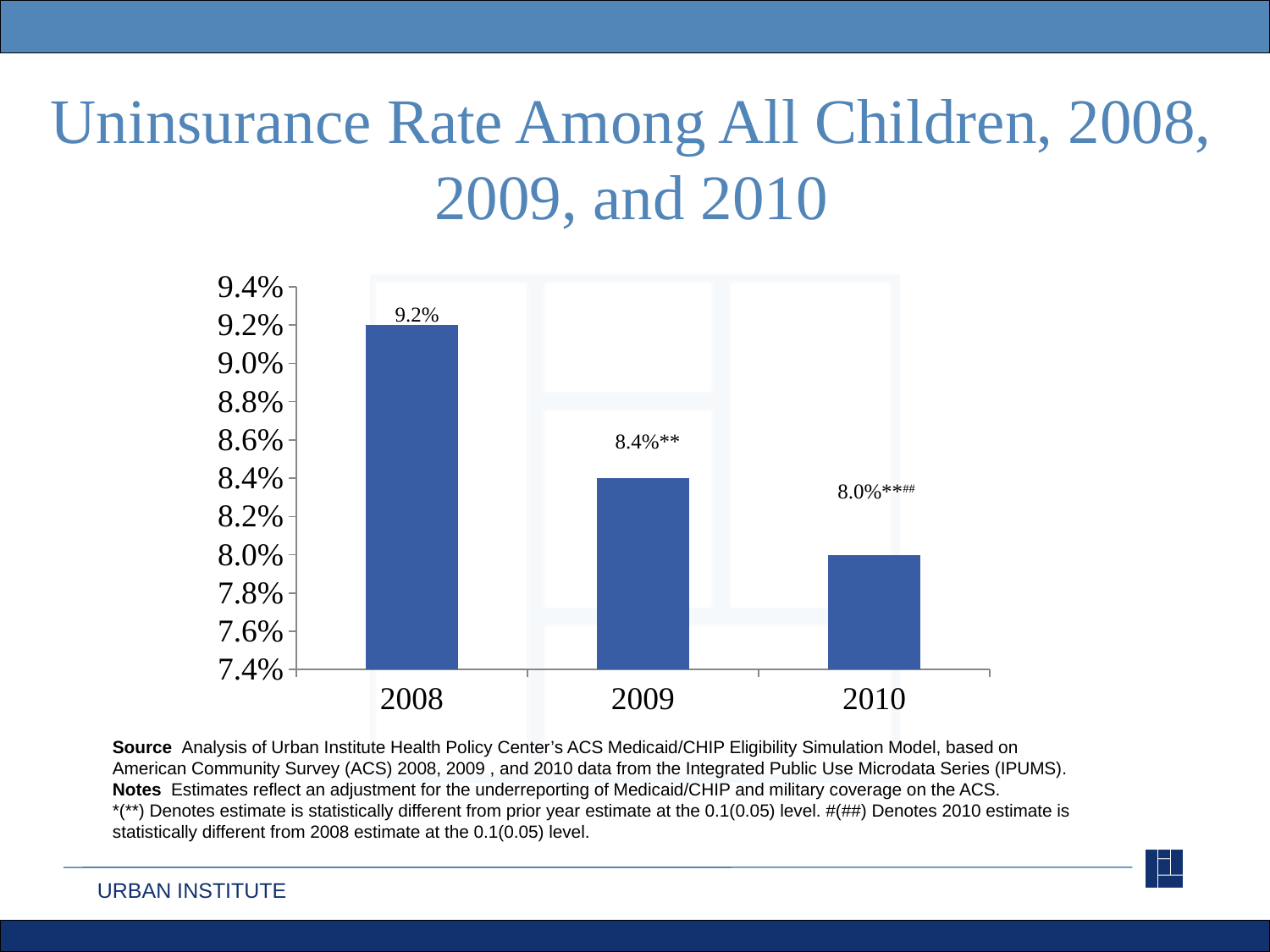
What is the uninsurance rate among all children in 2010? 8.0% Which year has the lowest uninsurance rate? 2010 How many years are shown in the chart? 3 Which year has the highest uninsurance rate? 2008 What is the uninsurance rate among all children in 2008? 9.2% Is the uninsurance rate for 2009 greater or less than 9.0%? less What is the uninsurance rate among all children in 2009? 8.4% Does the uninsurance rate rise or fall from 2008 to 2010? fall Which year has a higher uninsurance rate, 2009 or 2010? 2009 What is the difference in uninsurance rate between 2008 and 2010? 1.2% What is the difference in uninsurance rate between 2008 and 2009? 0.8% What kind of chart is shown on the slide? bar chart